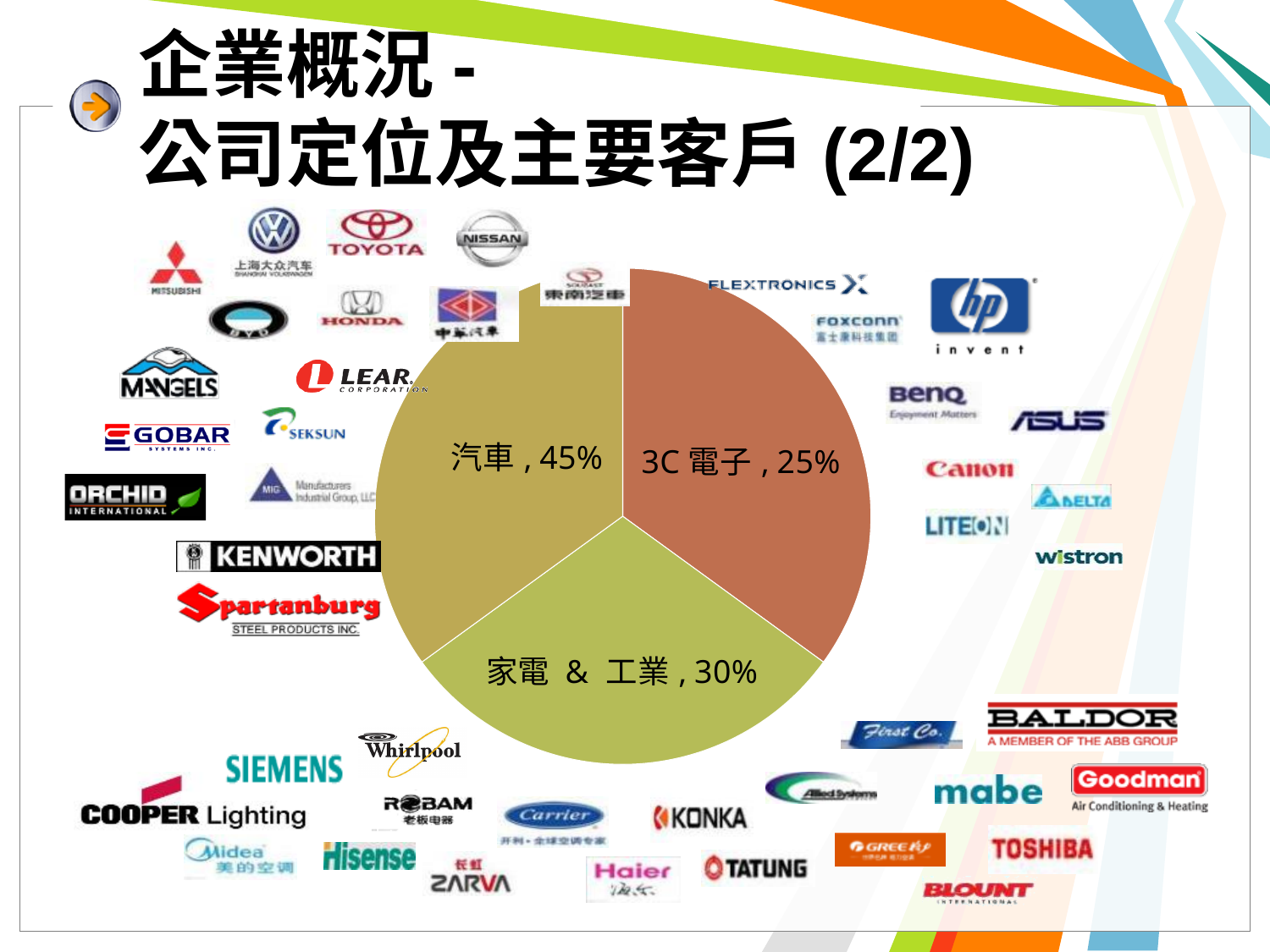
What share of the pie does 汽車 account for? 45% What is the difference in percentage points between the 汽車 slice and the 家電 & 工業 slice? 15 What share of the pie does 家電 & 工業 account for? 30% What share of the pie does 3C 電子 account for? 25% Which slice of the pie chart is the largest? 汽車 What is the combined share of the 3C 電子 and 家電 & 工業 slices? 55% Which is larger, the share for 家電 & 工業 or the share for 3C 電子? 家電 & 工業 Which slice of the pie chart is the smallest? 3C 電子 What kind of chart is shown on the slide? pie chart What is the title of the slide containing the pie chart? 企業概況 - 公司定位及主要客戶 (2/2) How many slices does the pie chart have? 3 What is the difference in percentage points between the 汽車 slice and the 3C 電子 slice? 20